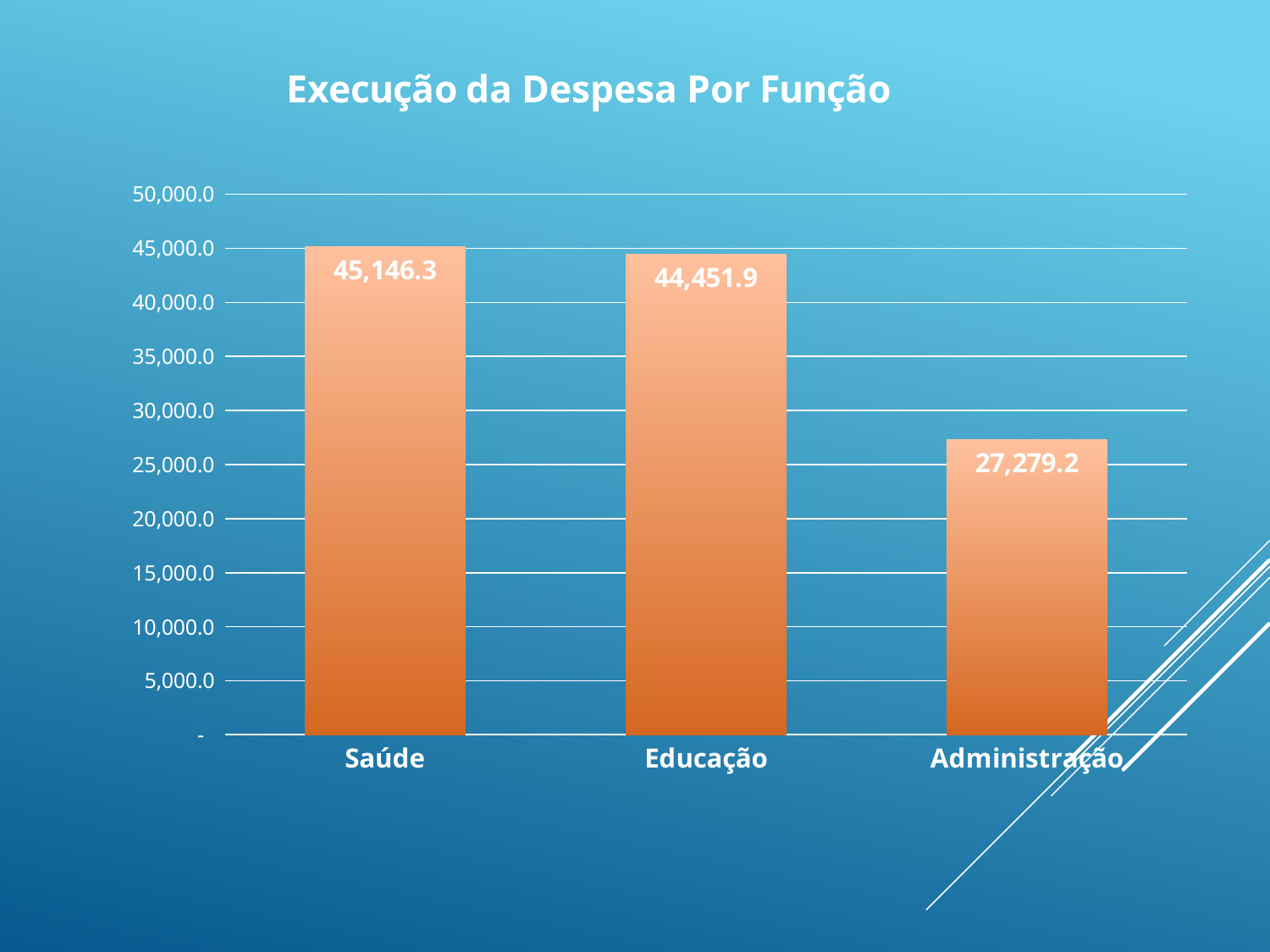
What is the difference between the values for Saúde and Educação? 694.4 Which is larger, the value for Saúde or the value for Educação? Saúde What is the value for Administração? 27,279.2 Which category has the highest value? Saúde What is the difference between the values for Educação and Administração? 17,172.7 What is the title of the chart? Execução da Despesa Por Função Is the value for Administração greater or less than 30,000.0? less Which category has the lowest value? Administração What is the value for Educação? 44,451.9 What kind of chart is shown on the slide? bar chart What is the value for Saúde? 45,146.3 How many categories are shown on the x axis? 3